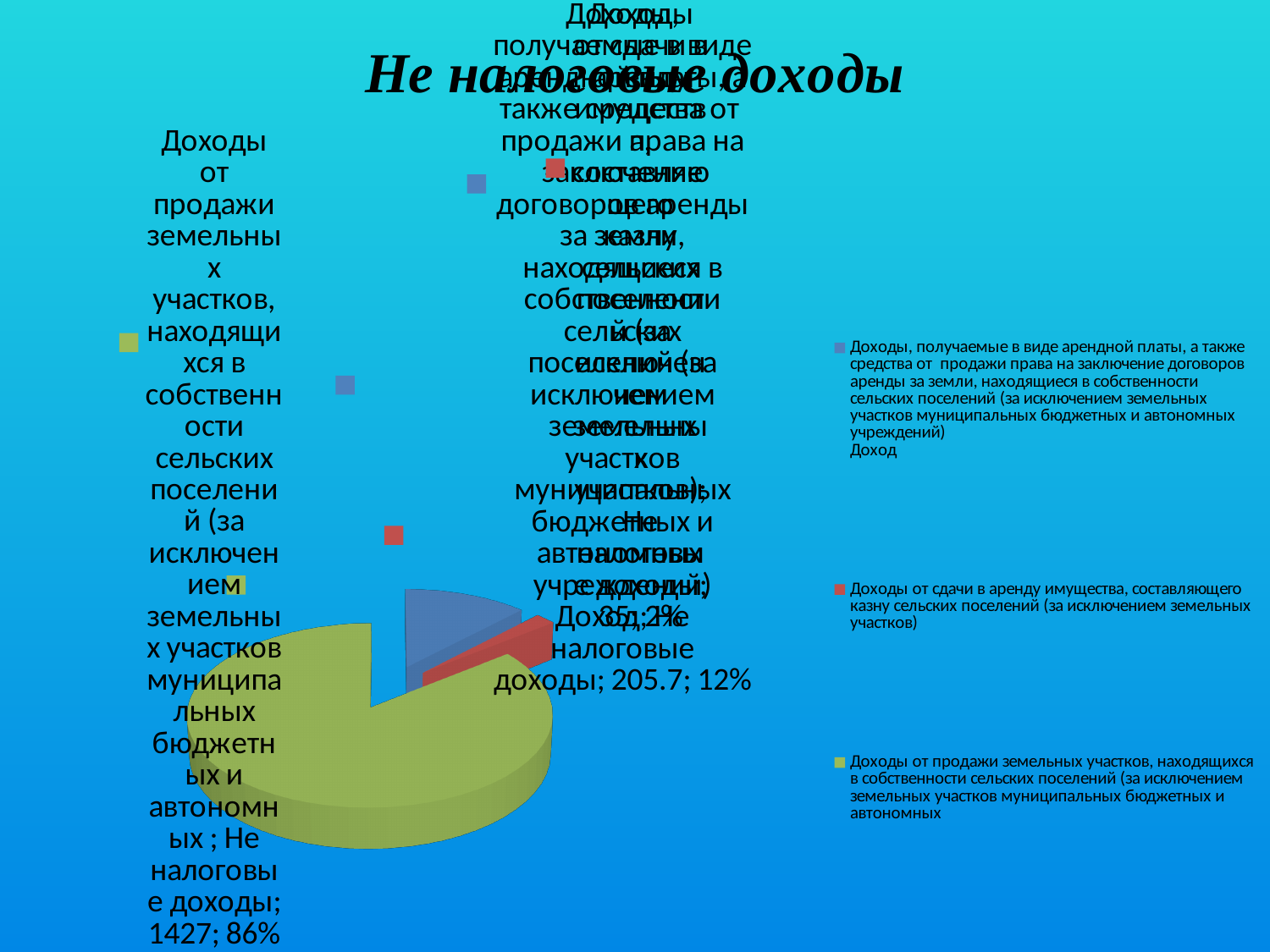
What is the value shown for the slice 'Доходы от сдачи в аренду имущества, составляющего казну сельских поселений'? 35 What is the title of the slide containing the pie chart? Не налоговые доходы Which is larger: the value for 'Доходы от сдачи в аренду имущества' or the value for 'Доходы от продажи земельных участков'? Доходы от продажи земельных участков How many entries does the legend of the pie chart list? 3 Which slice of the pie chart is the smallest? Доходы от сдачи в аренду имущества, составляющего казну сельских поселений What share of the pie does the slice 'Доходы от продажи земельных участков, находящихся в собственности сельских поселений' represent? 86% Which slice of the pie chart is the largest? Доходы от продажи земельных участков, находящихся в собственности сельских поселений What is the difference between the value for 'Доходы от продажи земельных участков' (1427) and the value for 'Доходы от сдачи в аренду имущества' (205.7)? 1221.3 How many slices does the pie chart have? 3 What share of the pie does the slice 'Доходы от сдачи в аренду имущества, составляющего казну сельских поселений' represent? 2% What kind of chart is shown on the slide? pie chart What is the value shown for the slice 'Доходы от продажи земельных участков, находящихся в собственности сельских поселений'? 1427